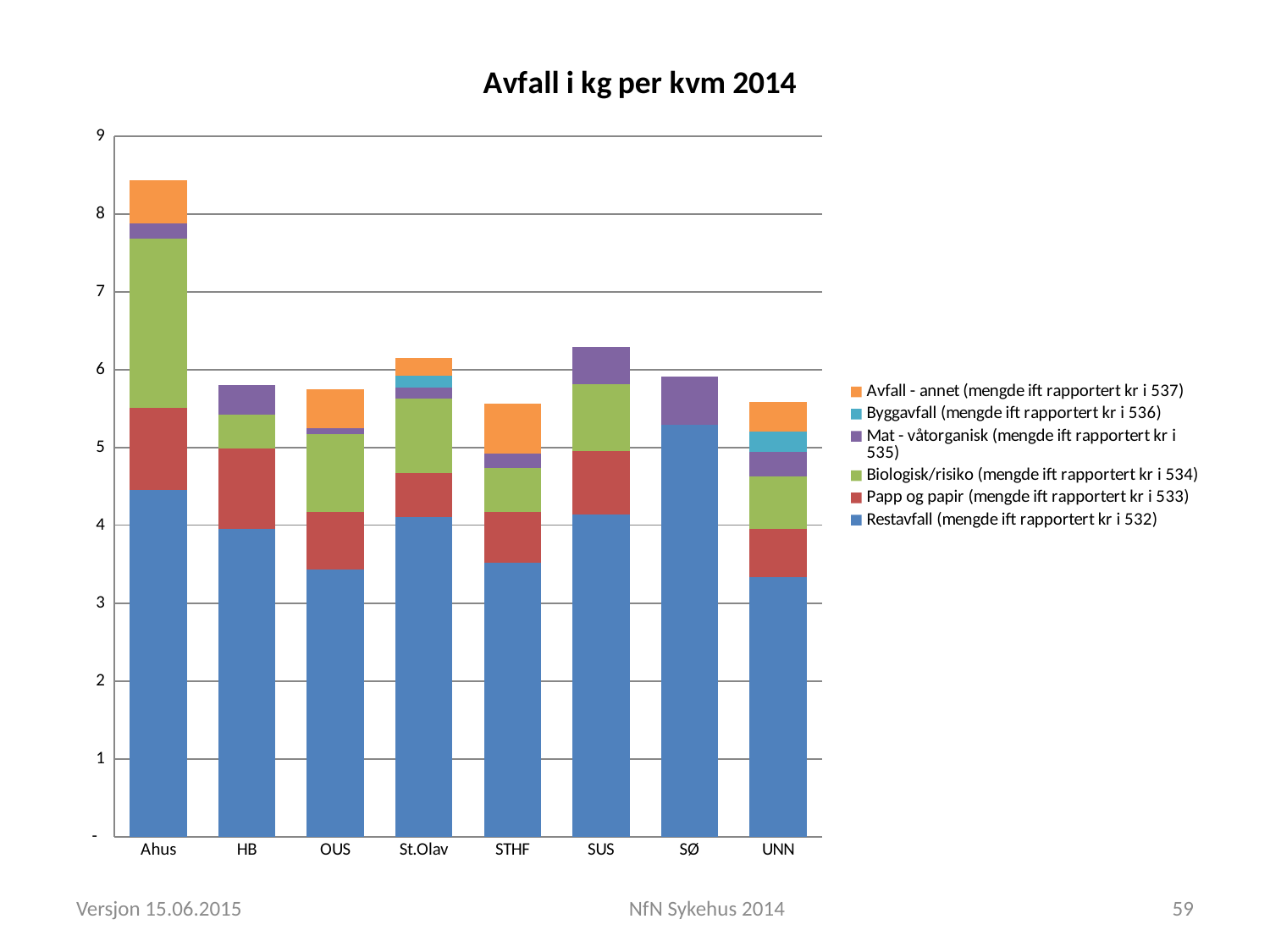
What kind of chart is shown on the slide? Stacked bar chart Is the total value for Ahus greater or less than 8? greater Which colour represents Restavfall in the chart? Blue How many hospitals (categories) are shown on the x axis? 8 Is the total value for OUS greater or less than 6? less Is the total value for SUS greater or less than 6? greater How many series does the legend list? 6 What is the title of the chart? Avfall i kg per kvm 2014 Which hospital has the highest total stacked bar? Ahus Which has the larger Restavfall value, SØ or UNN? SØ